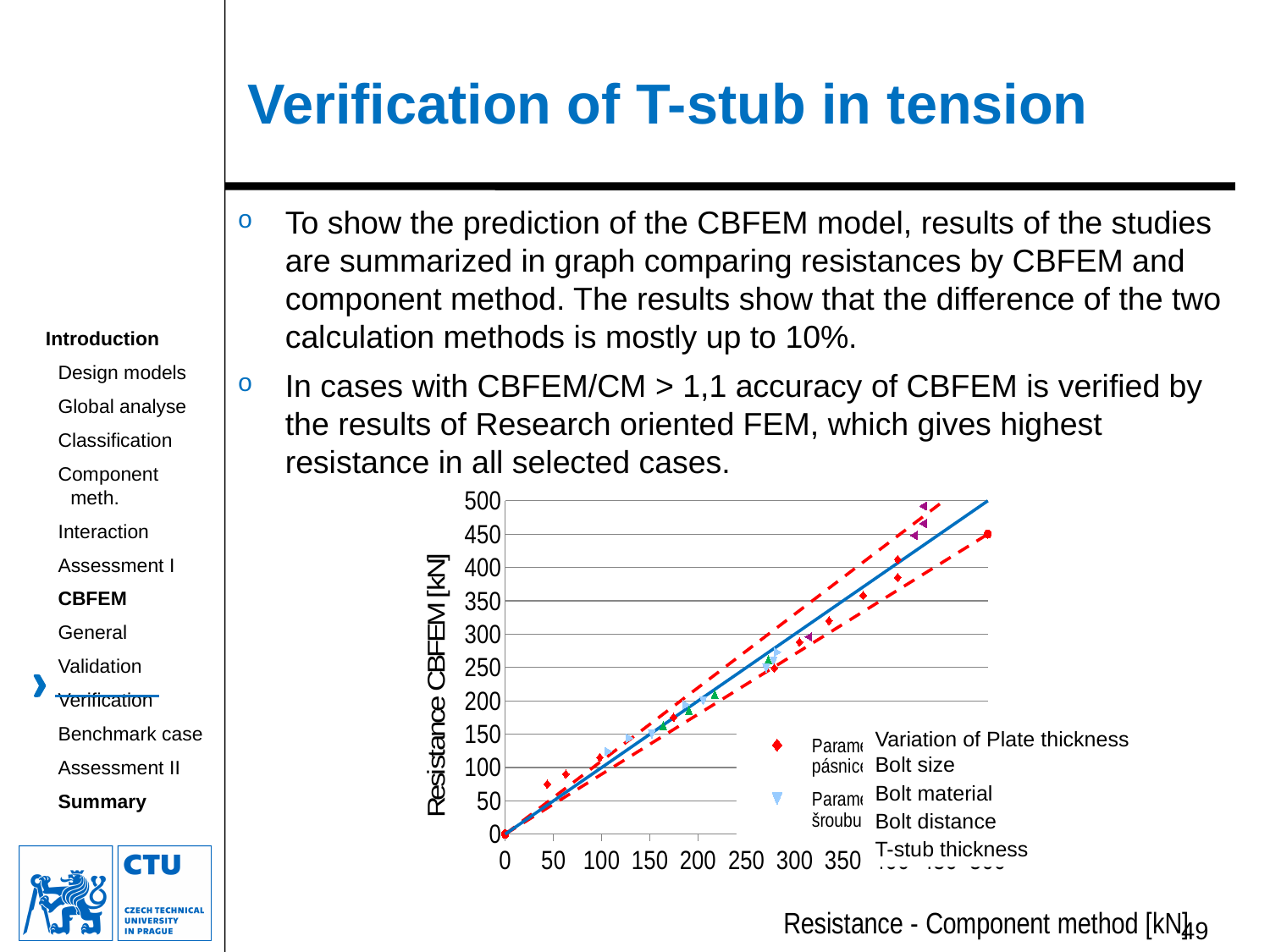
Is the highest plotted point on the chart greater or less than 400 kN on the vertical axis? greater What is the title of the horizontal axis of the chart? Resistance - Component method [kN] How many series are listed in the legend text next to the chart? 5 Is the lowest plotted point on the chart greater or less than 50 kN on the vertical axis? less Do the plotted CBFEM resistance values rise or fall as the component method resistance increases along the x axis? rise What is the maximum value shown on the vertical axis of the chart? 500 What kind of chart is shown on the slide? scatter chart What is the title of the vertical axis of the chart? Resistance CBFEM [kN]